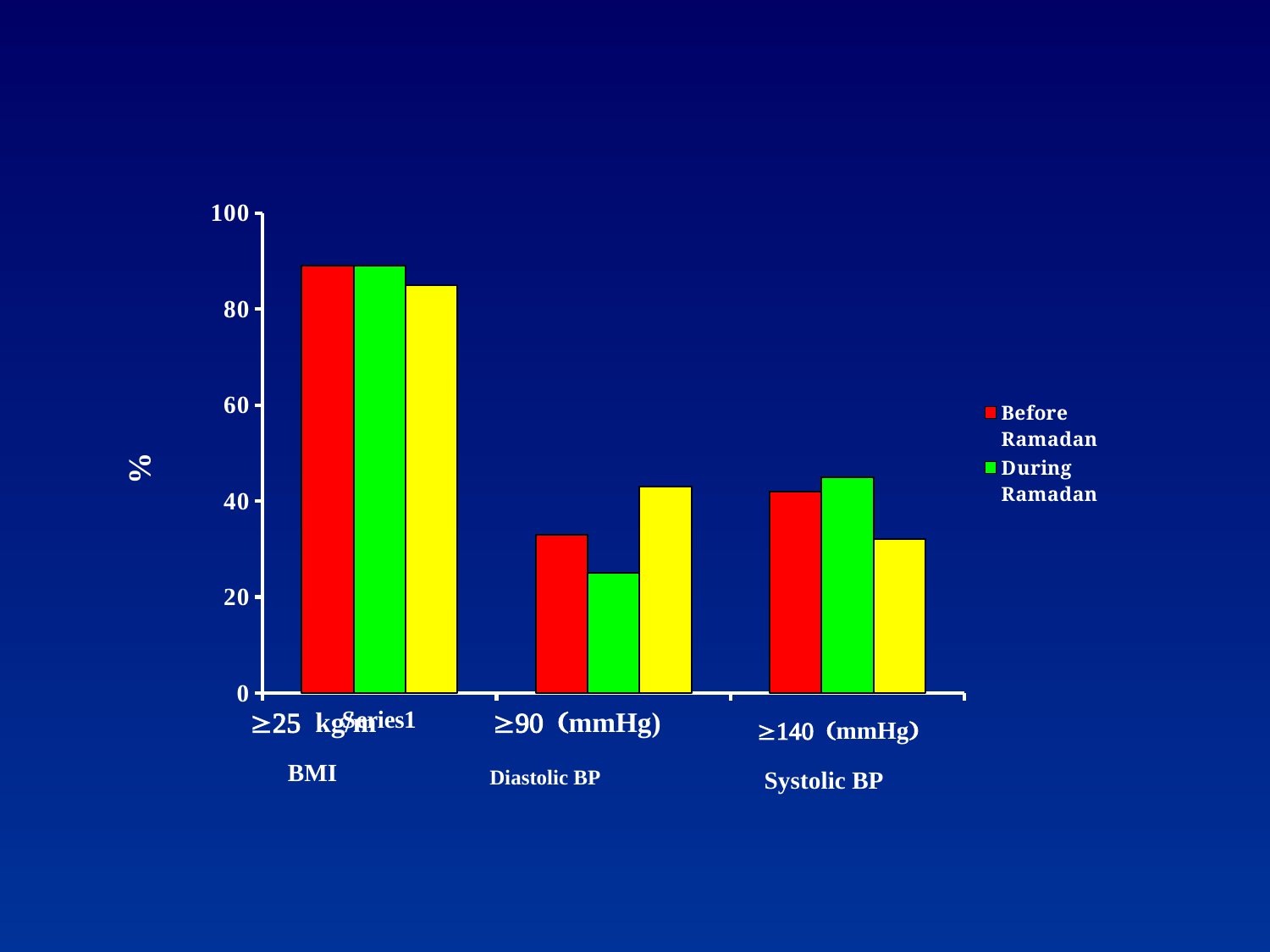
Is the Before Ramadan value for Systolic BP ≥140 mmHg greater or less than 60? less What is the label on the y axis? % Is the Before Ramadan value for BMI ≥25 kg/m² greater or less than 80? greater How many categories are shown along the x axis? 3 For During Ramadan, which is larger: the value for Diastolic BP ≥90 mmHg or the value for Systolic BP ≥140 mmHg? Systolic BP ≥140 mmHg What colour represents During Ramadan in the legend? green Which category has the highest Before Ramadan value? BMI ≥25 kg/m² Which category has the lowest During Ramadan value? Diastolic BP ≥90 mmHg Is the Before Ramadan value for Diastolic BP ≥90 mmHg greater or less than 20? greater How many series does the legend list? 2 What kind of chart is shown on the slide? bar chart